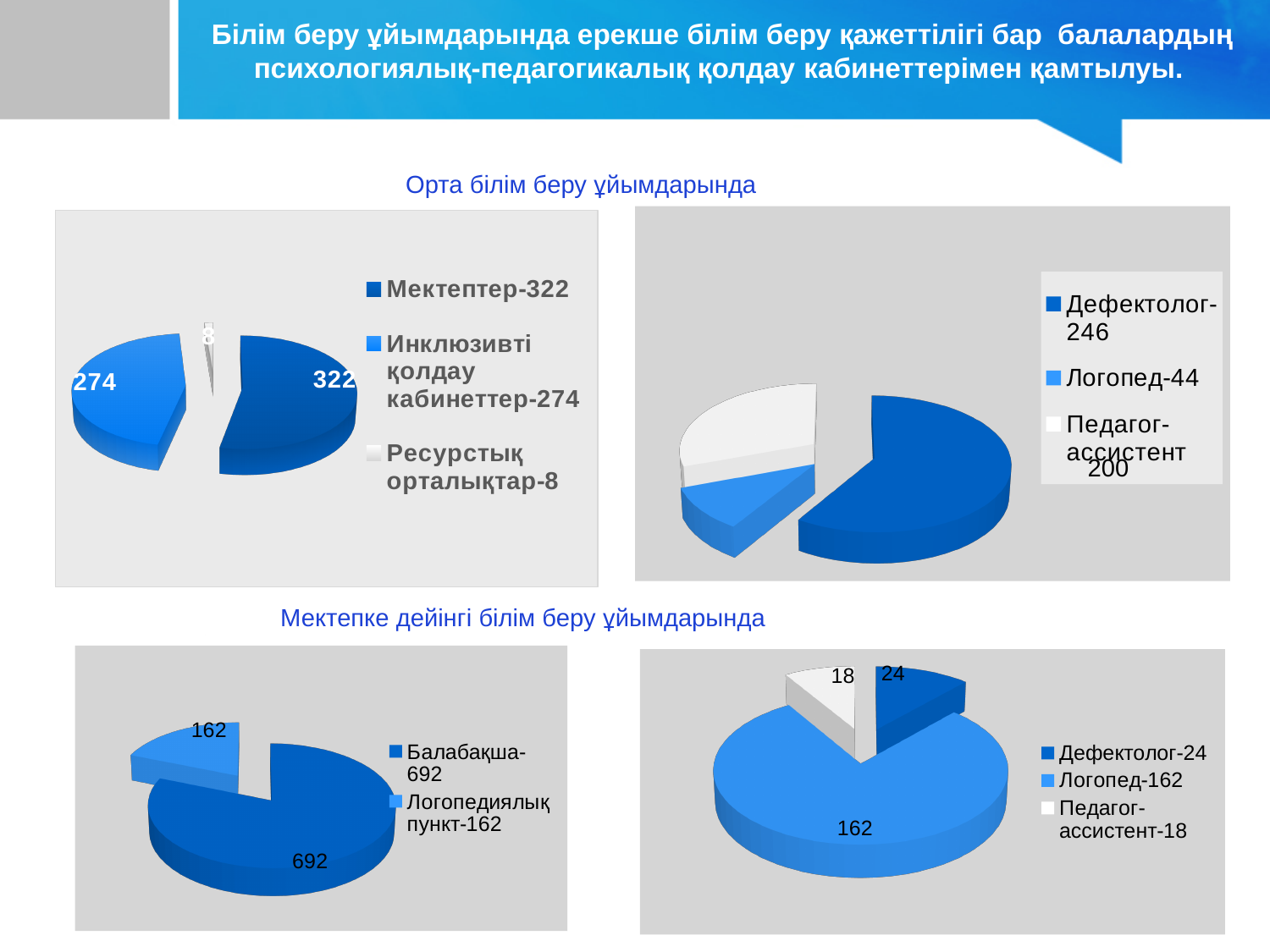
In the top-right pie chart, what is the value for Логопед? 44 In the bottom-left pie chart, what is the value for Балабақша? 692 In the top-right pie chart, which is larger, Дефектолог or Педагог-ассистент? Дефектолог In the top-left pie chart, what is the difference between Мектептер and Инклюзивті қолдау кабинеттер? 48 In the top-left pie chart, what is the value for Ресурстық орталықтар? 8 In the top-left pie chart, what is the value for Мектептер? 322 How many categories does the legend of the bottom-left pie chart list? 2 In the top-left pie chart, which category has the largest slice? Мектептер In the top-right pie chart, which category has the smallest slice? Логопед In the bottom-right pie chart, which category has the largest slice? Логопед In the bottom-right pie chart, what is the value for Педагог-ассистент? 18 What type of chart is the bottom-right chart? Pie chart